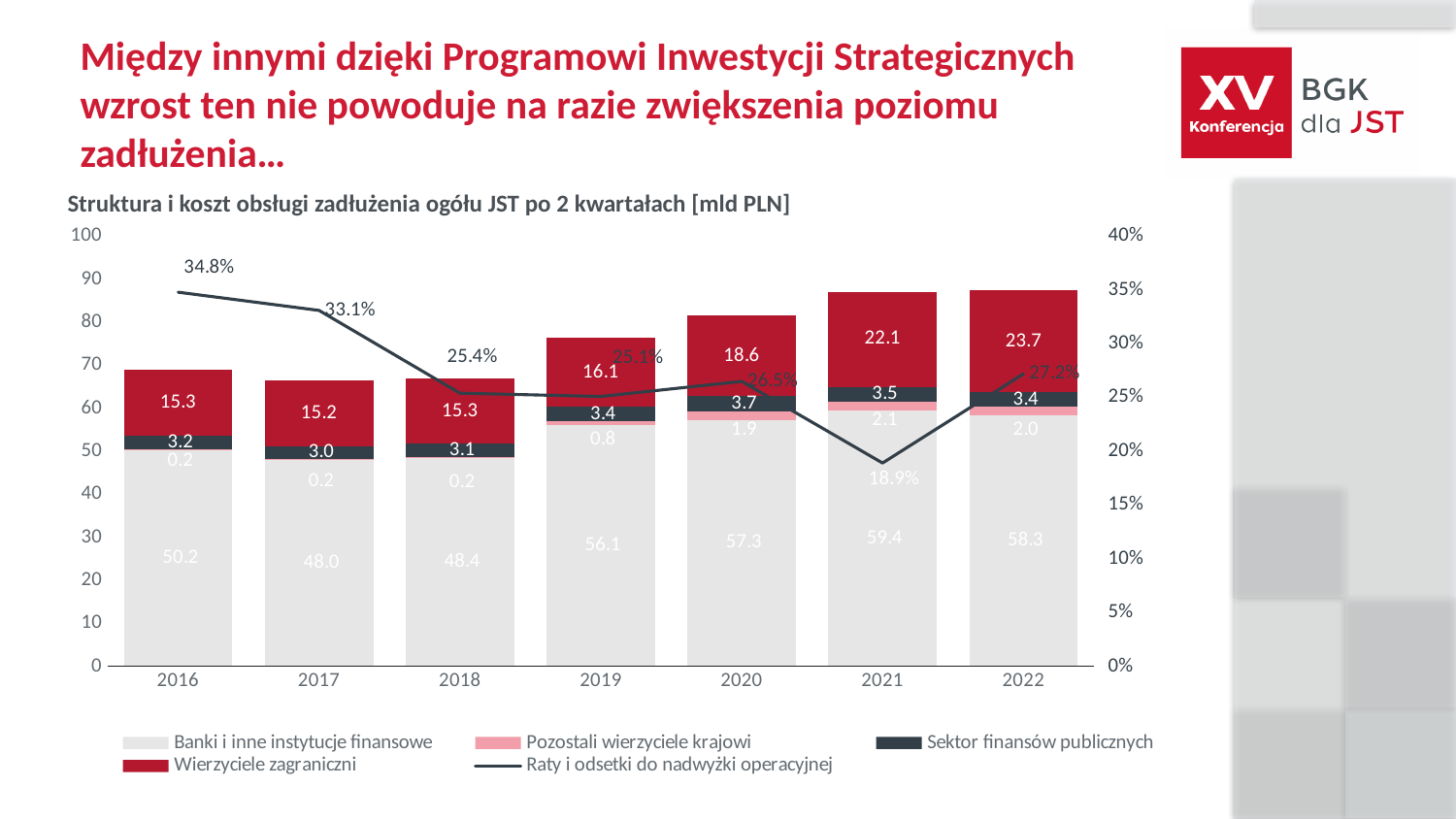
What is the value for Banki i inne instytucje finansowe in 2019? 56.1 What is the difference between the Wierzyciele zagraniczni values in 2022 and 2016? 8.4 Which is larger, the Banki i inne instytucje finansowe value in 2021 or in 2017? 2021 What is the value of the Raty i odsetki do nadwyżki operacyjnej line in 2016? 34.8% How many series does the legend list? 5 In which year is the value for Wierzyciele zagraniczni the highest? 2022 What is the title of the chart? Struktura i koszt obsługi zadłużenia ogółu JST po 2 kwartałach [mld PLN] In which year is the Raty i odsetki do nadwyżki operacyjnej line at its lowest? 2021 What is the value for Wierzyciele zagraniczni in 2022? 23.7 What is the total of the stacked bar for 2016? 68.9 How many years are shown on the x axis? 7 What kind of chart is shown on the slide? Stacked bar chart with a line